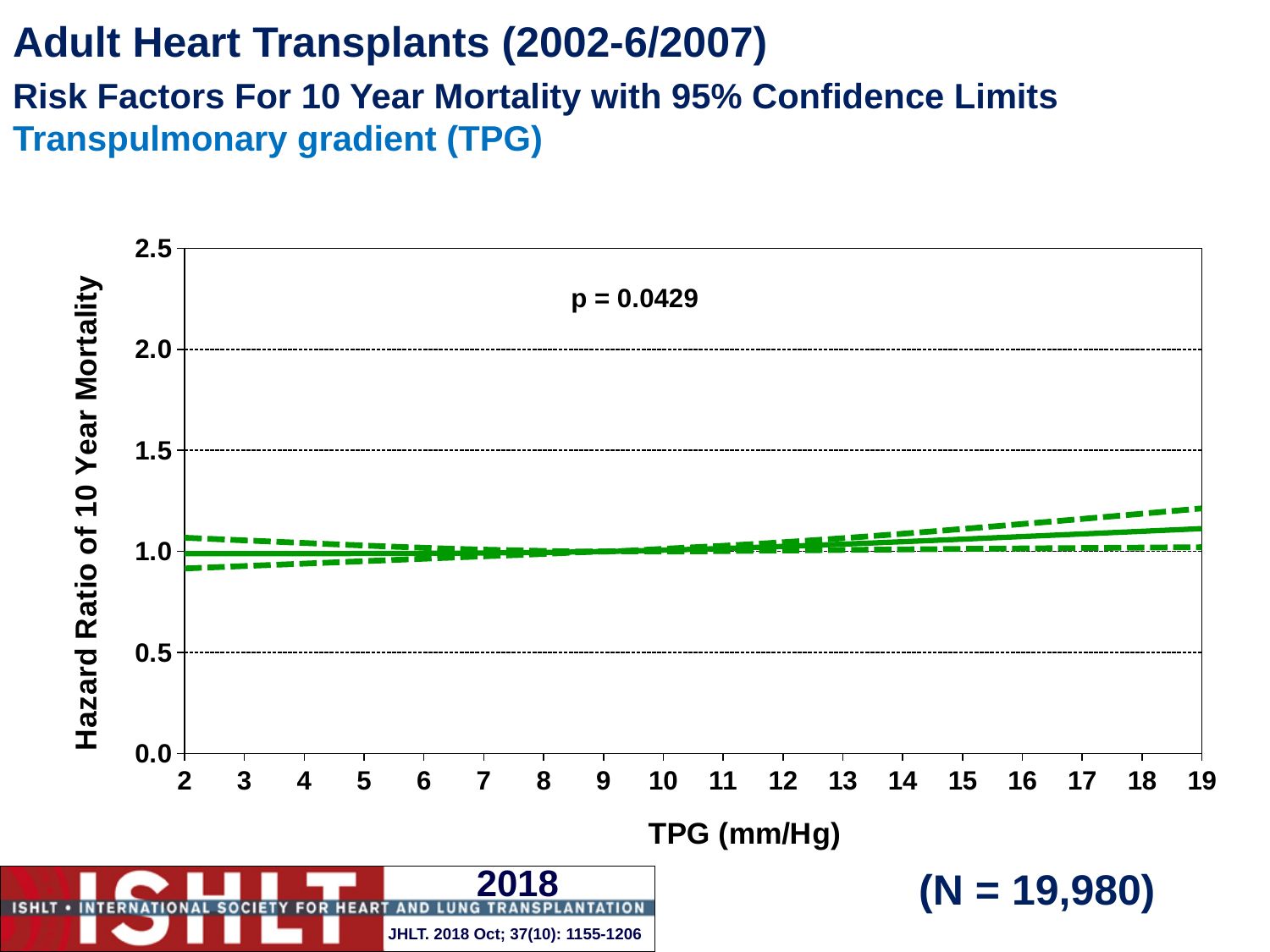
Is the hazard ratio (solid line) at a TPG of 10 mm/Hg greater or less than 2.0? less Is the hazard ratio (solid line) at a TPG of 19 mm/Hg greater or less than 1.0? greater What is the lowest TPG value labelled on the x axis? 2 What kind of chart is shown on the slide? line chart Is the upper 95% confidence limit at a TPG of 19 mm/Hg greater or less than 1.5? less What is the label of the x axis? TPG (mm/Hg) Does the solid hazard ratio line rise or fall as TPG increases from 2 to 19 mm/Hg? rises What is the highest value labelled on the y axis? 2.5 What is the p-value printed on the chart? p = 0.0429 How many tick values are labelled on the TPG (x) axis? 18